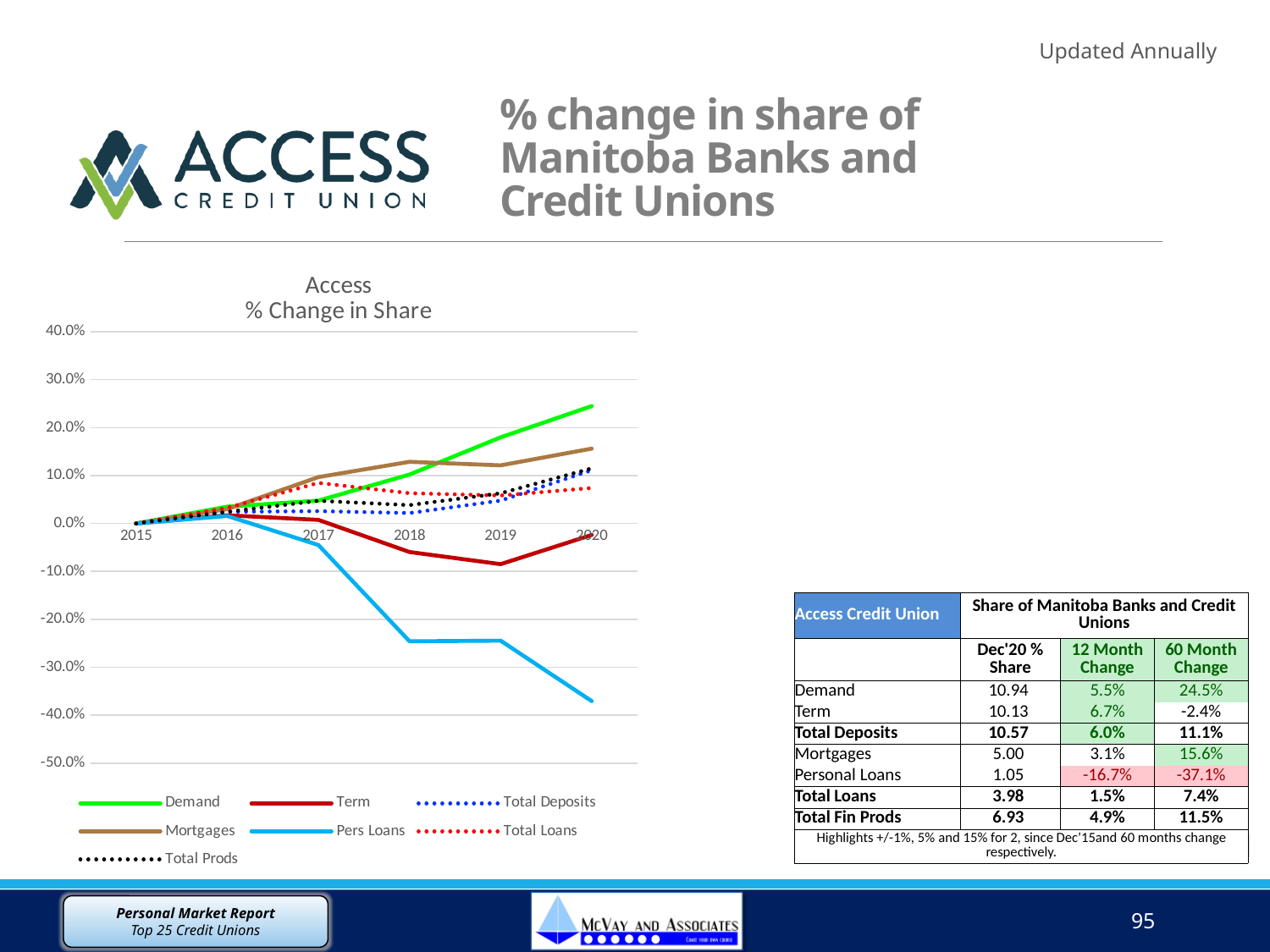
Does the Pers Loans line rise or fall from 2015 to 2020? fall Which series has the lowest value in 2020? Pers Loans Is the value for Mortgages in 2020 greater or less than 10.0%? greater What is the title of the chart? Access % Change in Share Is the value for Demand in 2020 greater or less than 20.0%? greater Is the value for Pers Loans in 2020 greater or less than -30.0%? less Which is larger in 2020, the value for Mortgages or the value for Term? Mortgages How many years are shown along the x axis of the chart? 6 What kind of chart is shown on the slide? line chart How many series does the chart legend list? 7 Which series has the highest value in 2020? Demand